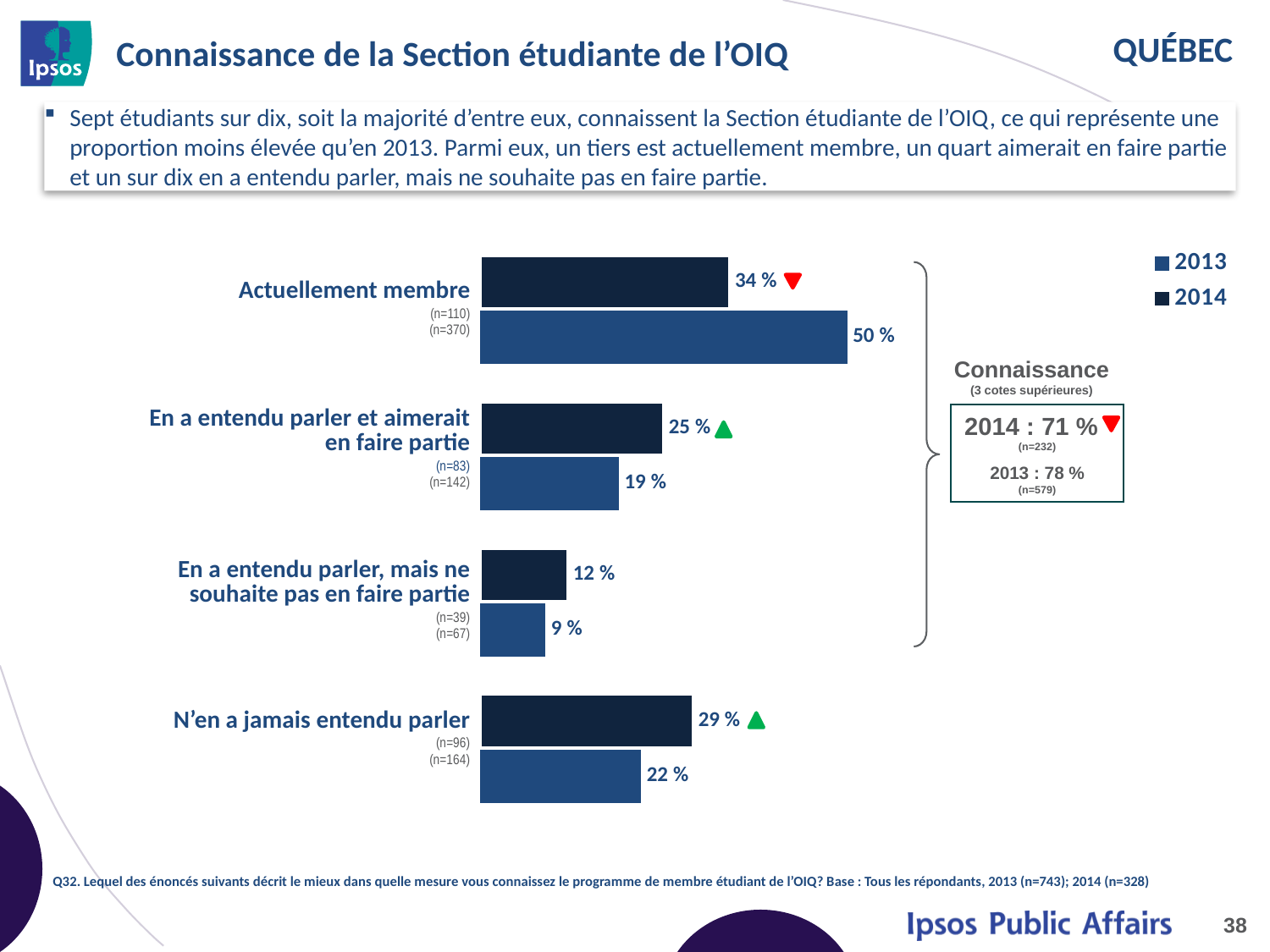
What is the value of the lower bar for "Actuellement membre"? 50 % Which category has the highest value on the chart? Actuellement membre What is the value of the upper bar for "En a entendu parler, mais ne souhaite pas en faire partie"? 12 % What is the value of the lower bar for "N'en a jamais entendu parler"? 22 % Which category has the lowest value on the chart? En a entendu parler, mais ne souhaite pas en faire partie How many series does the legend list? 2 How many categories are shown on the chart? 4 What type of chart is shown on the slide? bar chart What are the two entries in the chart legend? 2013 and 2014 What is the difference between the two bars for "Actuellement membre"? 16 percentage points What is the value of the upper bar for "Actuellement membre"? 34 % Which is larger: the upper bar for "En a entendu parler et aimerait en faire partie" or the upper bar for "N'en a jamais entendu parler"? N'en a jamais entendu parler